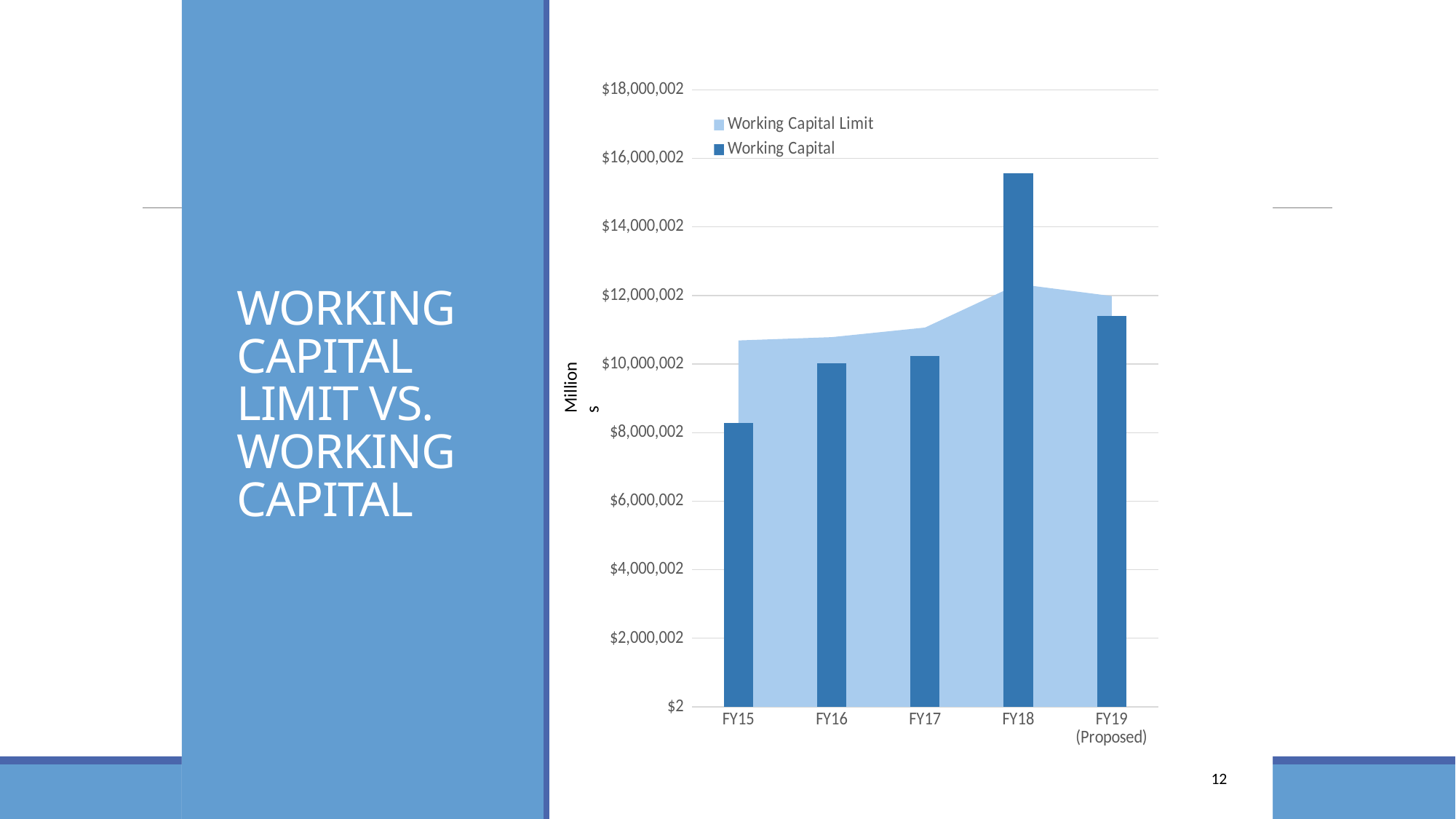
What kind of chart is shown on the slide? A combination bar and area chart Is the Working Capital value for FY15 greater or less than $10,000,002? less In FY15, which is larger: Working Capital or Working Capital Limit? Working Capital Limit What is the label on the vertical axis? Millions Is the Working Capital value for FY18 greater or less than $14,000,002? greater Which fiscal year has the lowest Working Capital bar? FY15 How many fiscal years are shown on the x axis? 5 How many series does the legend list? 2 In FY18, which is larger: Working Capital or Working Capital Limit? Working Capital Does the Working Capital Limit rise or fall from FY15 to FY18? rise Which fiscal year has the highest Working Capital bar? FY18 Is the Working Capital value for FY19 (Proposed) greater or less than $12,000,002? less